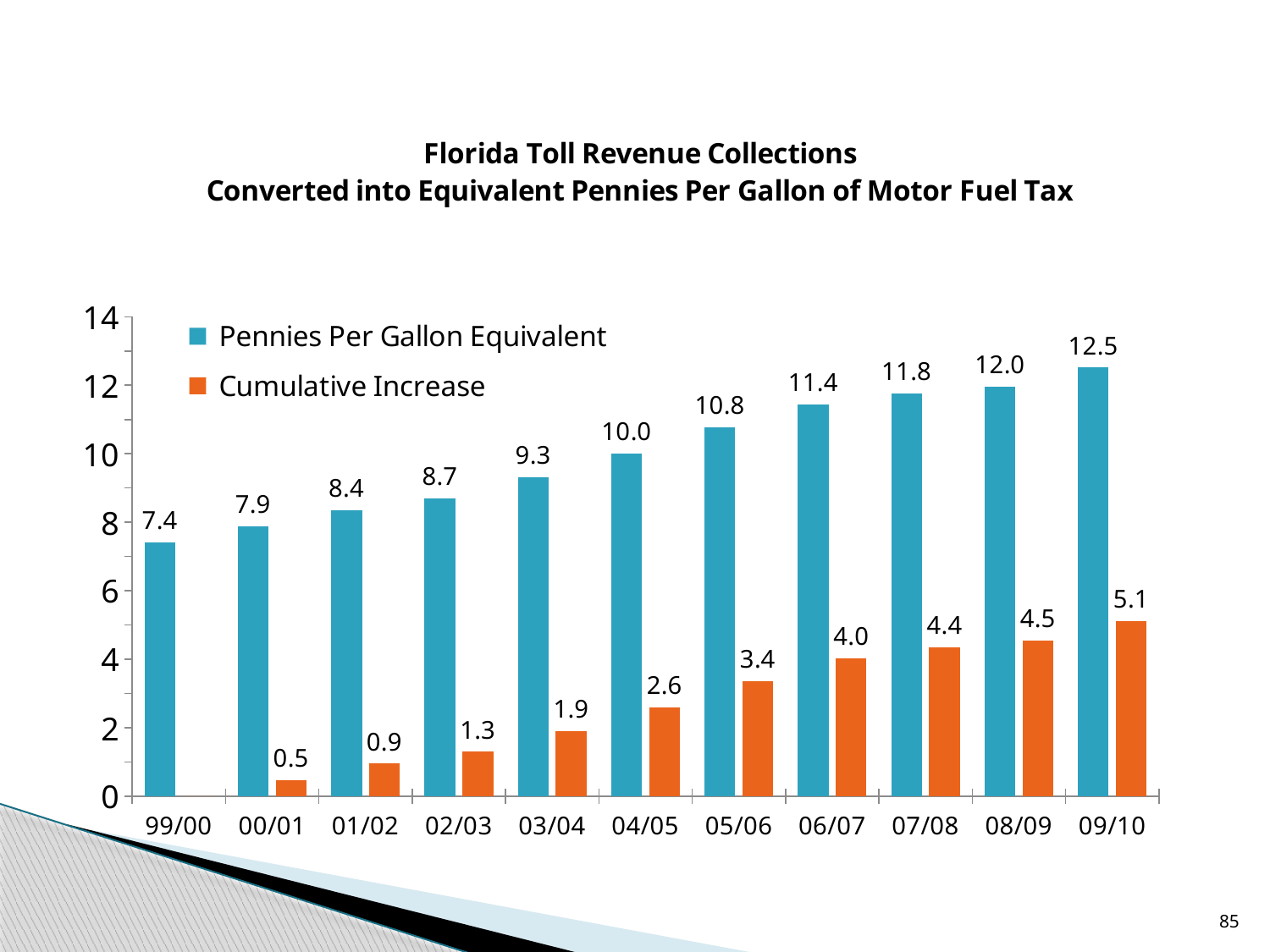
What is the difference between the Pennies Per Gallon Equivalent values for 09/10 and 99/00? 5.1 How many fiscal years are shown on the x axis? 11 Which year has the lowest Cumulative Increase value among those with a labelled orange bar? 00/01 What colour are the Cumulative Increase bars? Orange Which year has the highest Pennies Per Gallon Equivalent value? 09/10 What kind of chart is shown on the slide? Bar chart Is the Pennies Per Gallon Equivalent value for 05/06 greater or less than 10? greater Do the Pennies Per Gallon Equivalent values rise or fall from 99/00 to 09/10? Rise How many series does the legend list? 2 What is the Cumulative Increase value for 06/07? 4.0 Which is larger: the Cumulative Increase for 04/05 or for 05/06? 05/06 What is the Pennies Per Gallon Equivalent value for 03/04? 9.3